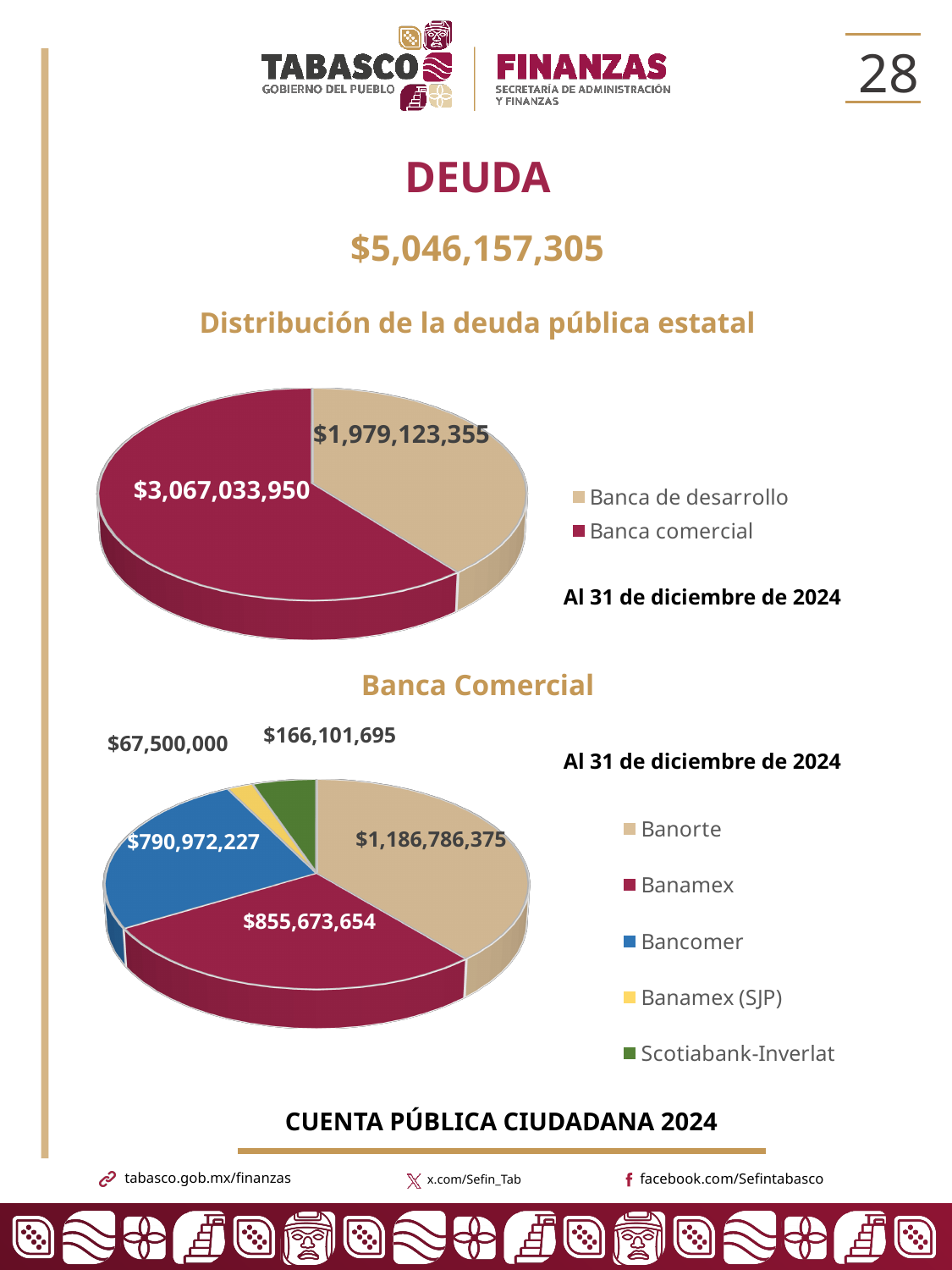
In the 'Banca Comercial' chart, what is the value for Banorte? $1,186,786,375 In the 'Banca Comercial' chart, how many categories are shown? 5 How many entries does the legend of the 'Distribución de la deuda pública estatal' chart list? 2 In the 'Banca Comercial' chart, which bank has the smallest slice? Banamex (SJP) In the 'Distribución de la deuda pública estatal' chart, what is the value for Banca comercial? $3,067,033,950 In the 'Banca Comercial' chart, what is the value for Bancomer? $790,972,227 In the 'Distribución de la deuda pública estatal' chart, what is the difference between Banca comercial and Banca de desarrollo? $1,087,910,595 In the 'Distribución de la deuda pública estatal' chart, which category is the largest? Banca comercial In the 'Banca Comercial' chart, what is the difference between Banorte and Banamex? $331,112,721 In the 'Banca Comercial' chart, what is the value for Scotiabank-Inverlat? $166,101,695 What type of chart is used for 'Distribución de la deuda pública estatal'? Pie chart In the 'Distribución de la deuda pública estatal' chart, what is the value for Banca de desarrollo? $1,979,123,355